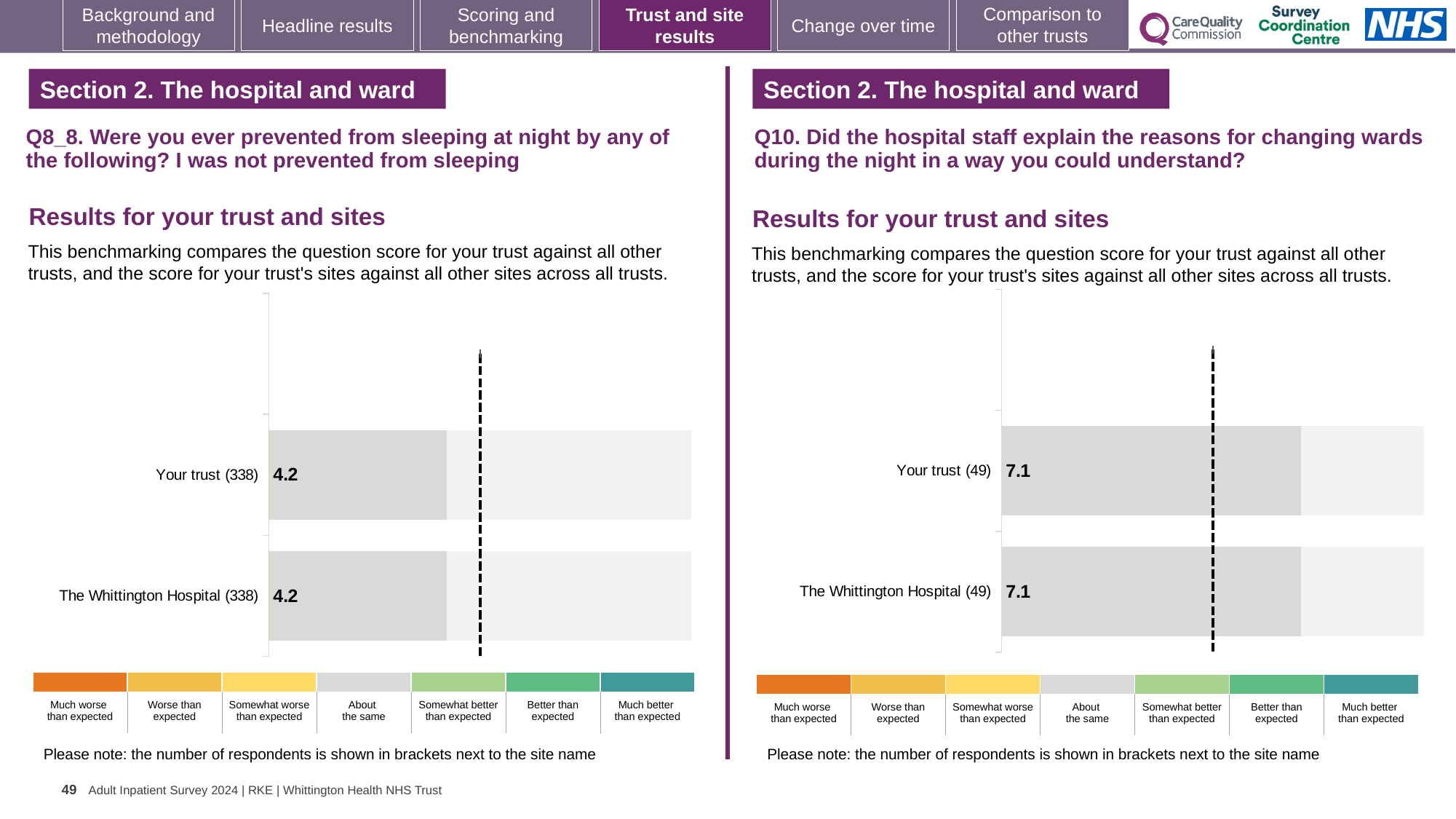
In the left chart (Q8_8), what is the score for The Whittington Hospital? 4.2 In the left chart (Q8_8), what is the score for Your trust? 4.2 In the right chart (Q10), what is the difference between the score for Your trust and the score for The Whittington Hospital? 0 What kind of chart is used in the left chart (Q8_8)? Bar chart What kind of chart is used in the right chart (Q10)? Bar chart How many bars are plotted in the right chart (Q10)? 2 In the right chart (Q10), how many respondents are shown in brackets for The Whittington Hospital? 49 In the left chart (Q8_8), how many respondents are shown in brackets for Your trust? 338 In the left chart (Q8_8), what is the difference between the score for Your trust and the score for The Whittington Hospital? 0 In the right chart (Q10), what is the score for The Whittington Hospital? 7.1 In the right chart (Q10), what is the score for Your trust? 7.1 How many bars are plotted in the left chart (Q8_8)? 2